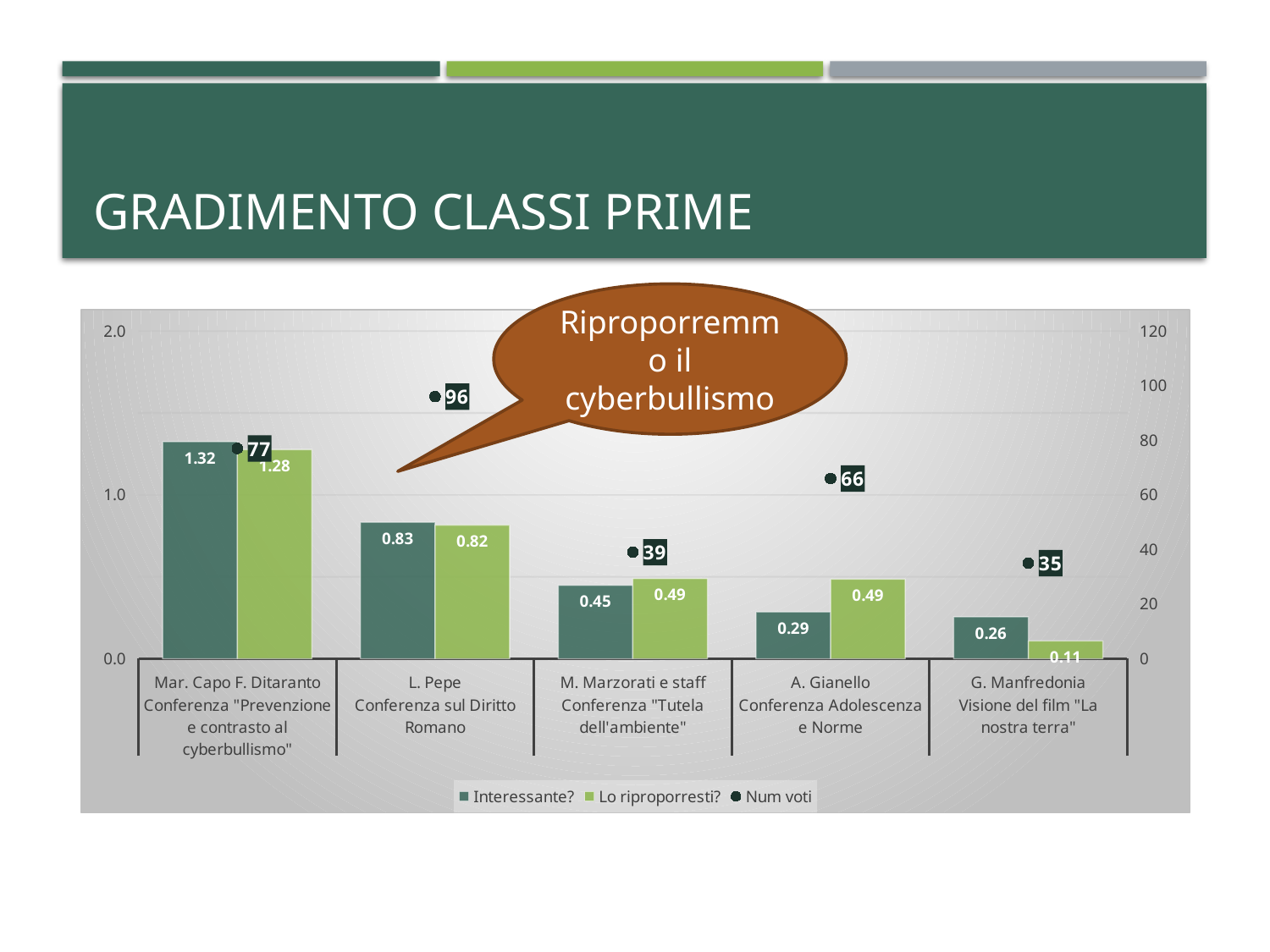
What is the "Interessante?" value for L. Pepe (Conferenza sul Diritto Romano)? 0.83 What is the "Num voti" value for M. Marzorati e staff (Conferenza "Tutela dell'ambiente")? 39 Do the "Interessante?" values rise or fall from left to right along the x axis? Fall What kind of chart is this? Bar chart with a dot (marker) series What is the "Lo riproporresti?" value for A. Gianello (Conferenza Adolescenza e Norme)? 0.49 What is the title of the slide containing the chart? GRADIMENTO CLASSI PRIME How many categories are shown on the x axis? 5 What is the difference between the "Interessante?" values for Mar. Capo F. Ditaranto and L. Pepe? 0.49 Which category has the lowest "Lo riproporresti?" value? G. Manfredonia (Visione del film "La nostra terra") How many series does the legend list? 3 Which category has the highest "Num voti" value? L. Pepe (Conferenza sul Diritto Romano) Which is larger for A. Gianello: the "Interessante?" value or the "Lo riproporresti?" value? Lo riproporresti?